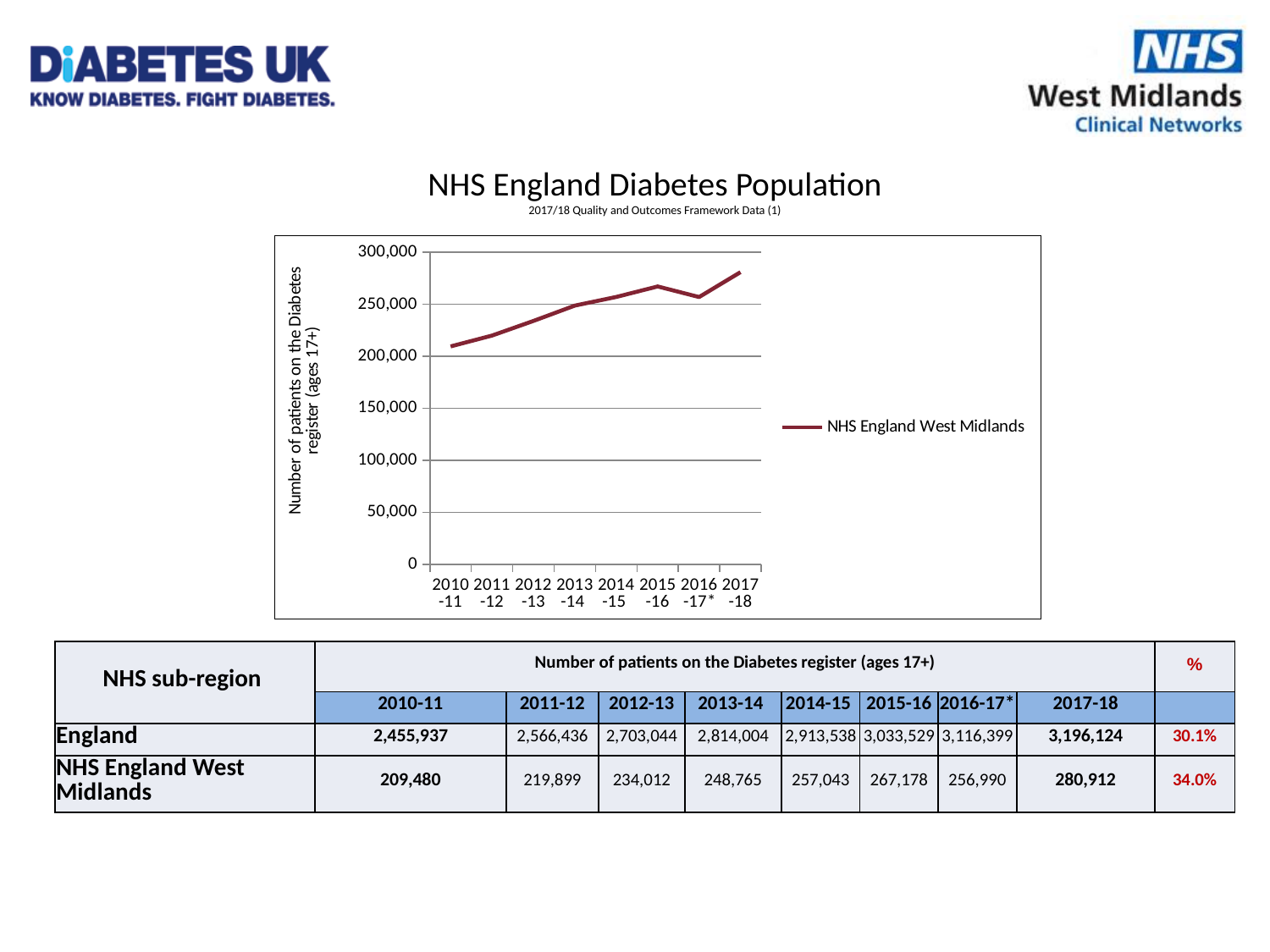
What kind of chart is shown on the slide? line chart Is the value for NHS England West Midlands higher in 2015-16 or in 2016-17*? 2015-16 What is the number of patients on the Diabetes register for NHS England West Midlands in 2017-18? 280,912 Overall, do the values for NHS England West Midlands rise or fall from 2010-11 to 2017-18? rise How many series does the chart legend list? 1 Which year has the lowest value for NHS England West Midlands on the chart? 2010-11 How many data points are plotted on the line for NHS England West Midlands? 8 What is the y-axis label of the chart? Number of patients on the Diabetes register (ages 17+) Is the value for NHS England West Midlands in 2017-18 greater or less than 250,000? greater Which year has the highest value for NHS England West Midlands on the chart? 2017-18 Is the value for NHS England West Midlands in 2010-11 greater or less than 250,000? less Which series is shown in the chart legend? NHS England West Midlands